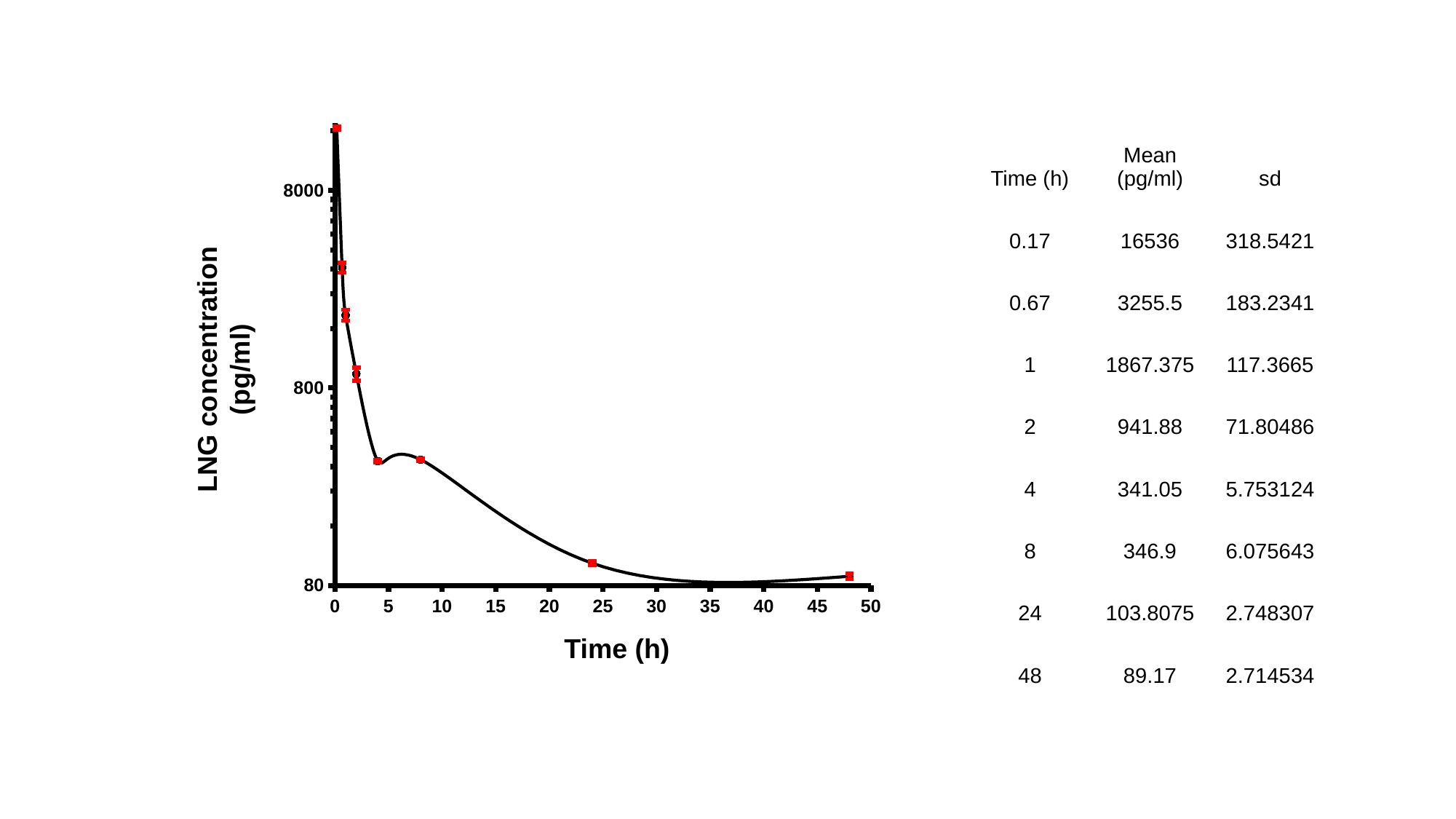
At which time point is the mean LNG concentration lowest? 48 h Is the mean LNG concentration at 48 h greater or less than 800? less What is the sd value at 4 h? 5.753124 Does the LNG concentration generally rise or fall as time increases? fall What is the mean LNG concentration at 0.17 h? 16536 How many time points are plotted on the chart? 8 What is the difference between the mean LNG concentration at 1 h and at 2 h? 925.495 At which time point is the mean LNG concentration highest? 0.17 h What is the mean LNG concentration at 24 h? 103.8075 Which has the larger mean LNG concentration, 4 h or 8 h? 8 h What is the label of the x axis? Time (h) What type of chart is shown on the slide? line chart